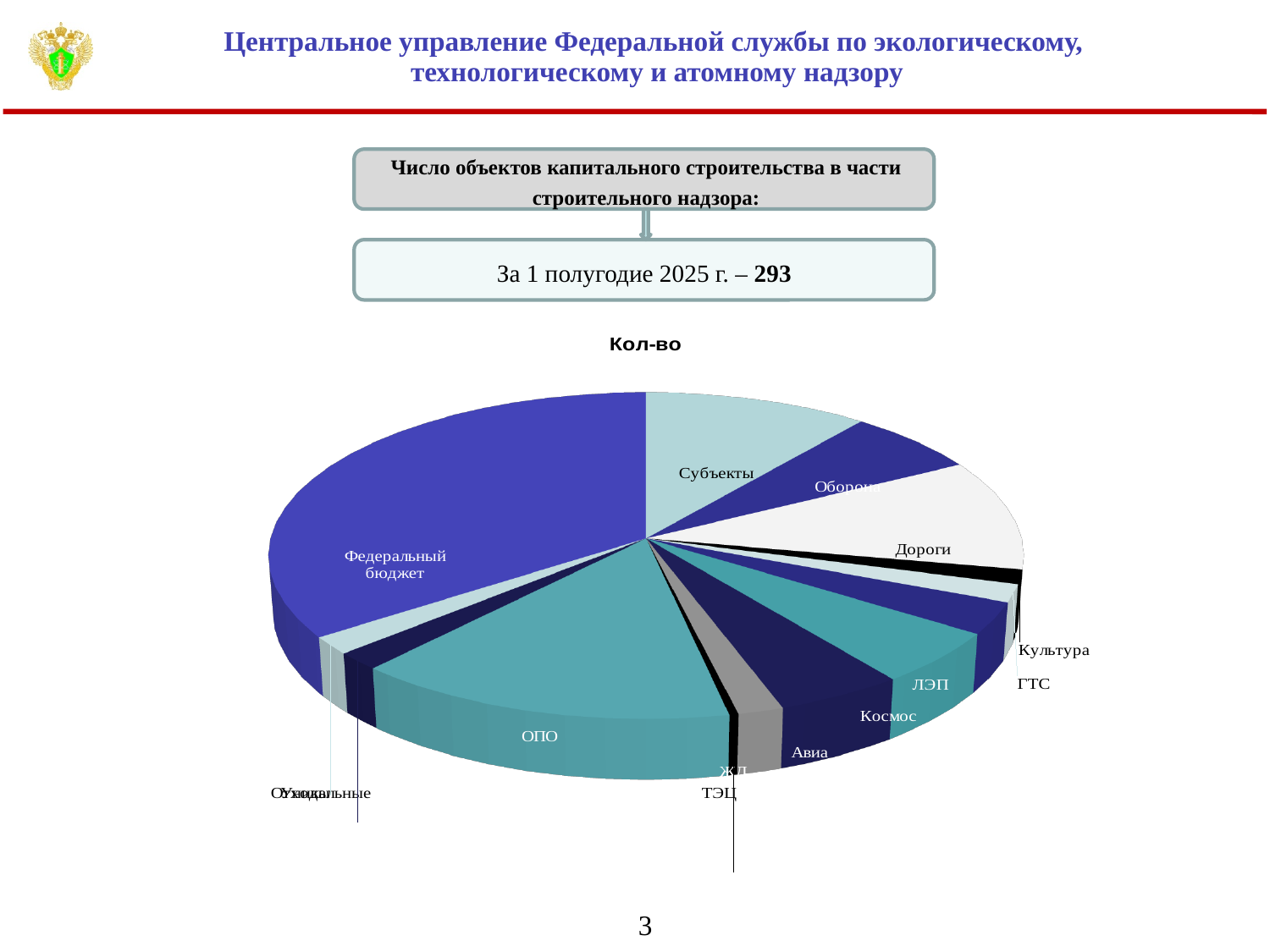
What is the title of the chart? Кол-во Which slice is larger, Дороги or ГТС? Дороги Which slice is larger, Субъекты or Культура? Субъекты Which slice is larger, ОПО or Дороги? ОПО Does the chart have a legend? No Which category has the largest slice of the pie? Федеральный бюджет What kind of chart is shown on the slide? pie chart